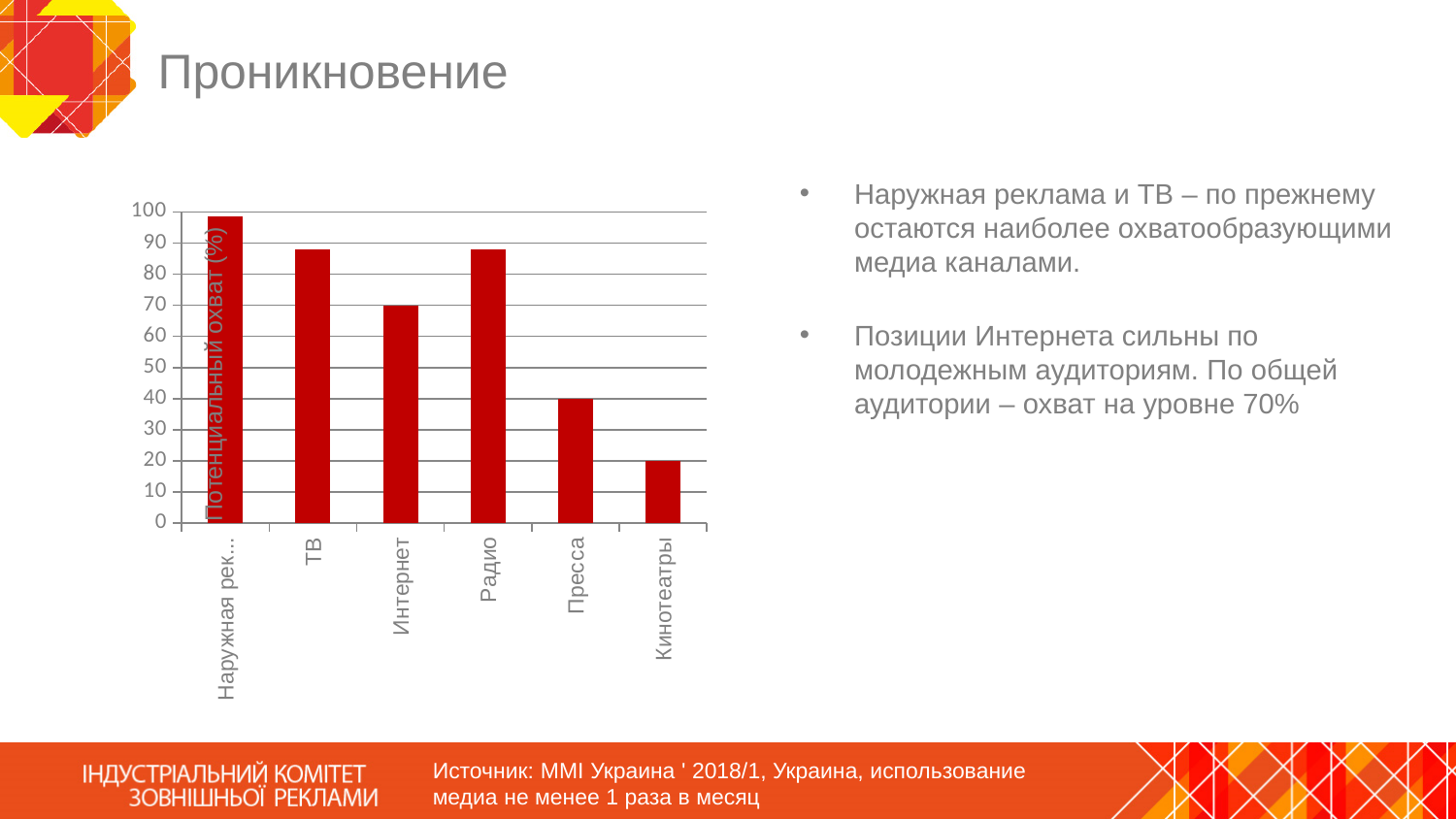
What type of chart is shown on the slide? bar chart What is the value for Интернет in the chart? 70 Which category has the highest value in the chart? Наружная реклама Is the value for ТВ greater or less than 80? greater Which category has the lowest value in the chart? Кинотеатры Which is larger, the value for Интернет or the value for Радио? Радио Is the value for Радио greater or less than 80? greater What is the value for Кинотеатры in the chart? 20 What is the difference between the values for Интернет and Пресса? 30 How many categories are shown on the x axis of the chart? 6 What is the title of the vertical axis of the chart? Потенциальный охват (%) What is the value for Пресса in the chart? 40